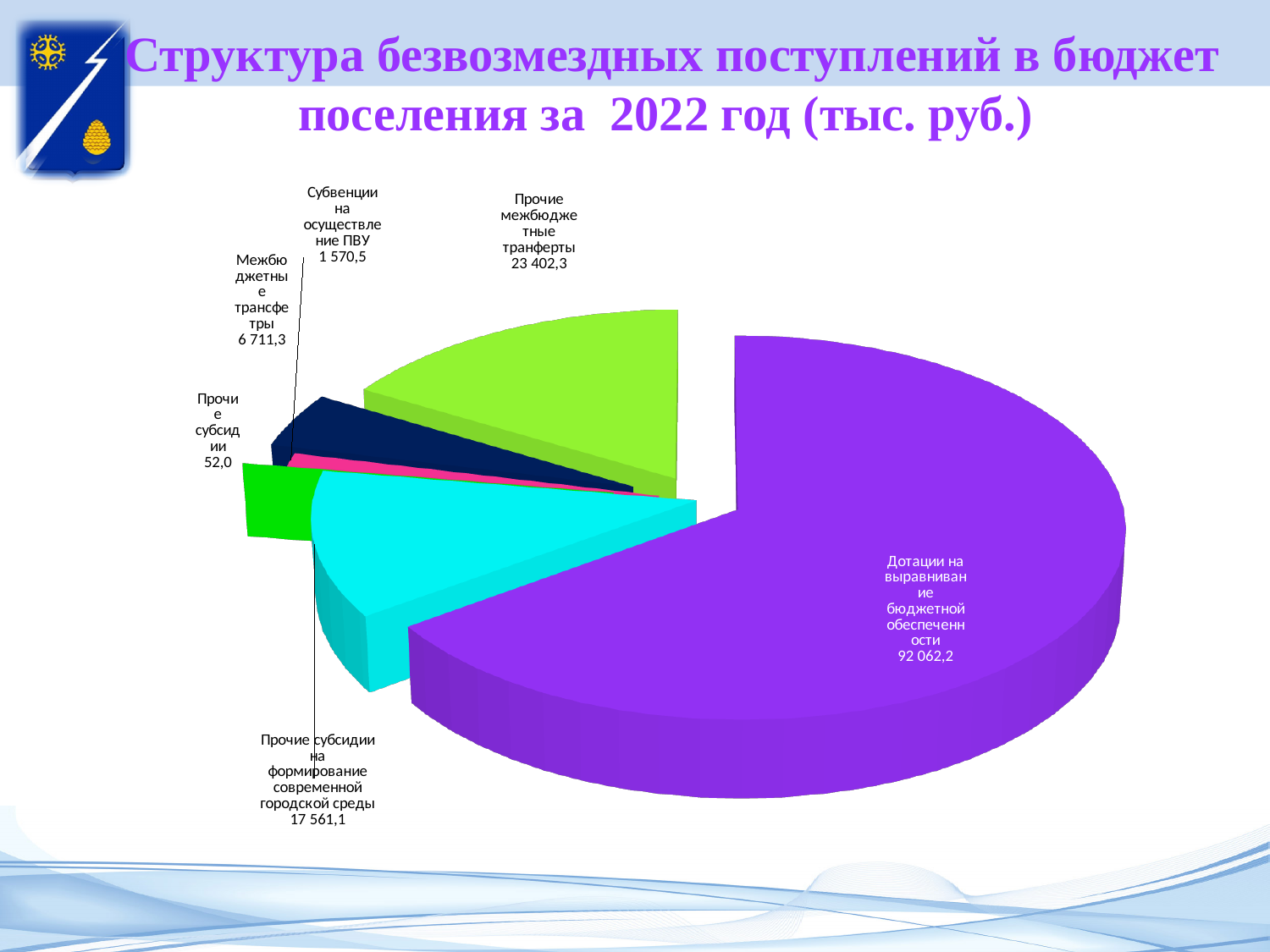
What is the value for "Субвенции на осуществление ПВУ"? 1 570,5 What colour is the largest slice of the pie chart? Purple Which category has the smallest value? Прочие субсидии What is the value for "Прочие субсидии на формирование современной городской среды"? 17 561,1 What is the value for "Межбюджетные трансферты"? 6 711,3 What is the difference between "Прочие межбюджетные трансферты" and "Прочие субсидии на формирование современной городской среды"? 5 841,2 What is the value for "Дотации на выравнивание бюджетной обеспеченности"? 92 062,2 How many categories (slices) does the pie chart have? 6 What is the value for "Прочие межбюджетные трансферты"? 23 402,3 Which category has the largest value? Дотации на выравнивание бюджетной обеспеченности Which is larger: "Межбюджетные трансферты" or "Субвенции на осуществление ПВУ"? Межбюджетные трансферты What kind of chart is shown on the slide? Pie chart